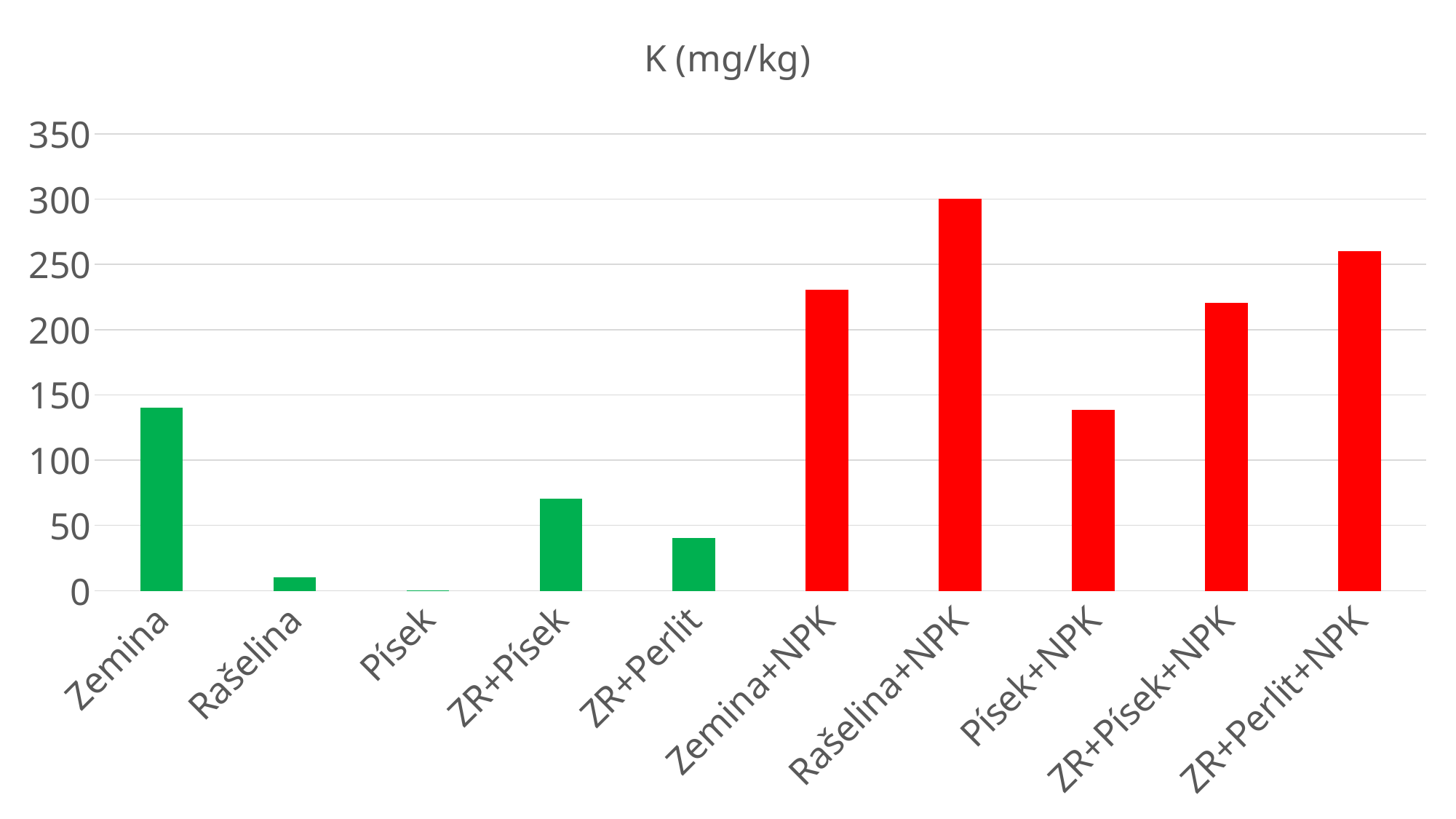
Is the value for Zemina greater or less than 100? greater Is the value for ZR+Písek greater or less than 50? greater What kind of chart is shown on the slide? bar chart Which is larger, the value for Zemina+NPK or the value for ZR+Perlit+NPK? ZR+Perlit+NPK Is the value for Zemina+NPK greater or less than 200? greater How many categories are shown on the x axis? 10 What is the title of the chart? K (mg/kg) What is the value for Rašelina+NPK? 300 What colour are the bars for the categories ending in +NPK? red Which category has the lowest value? Písek Which category has the highest value? Rašelina+NPK